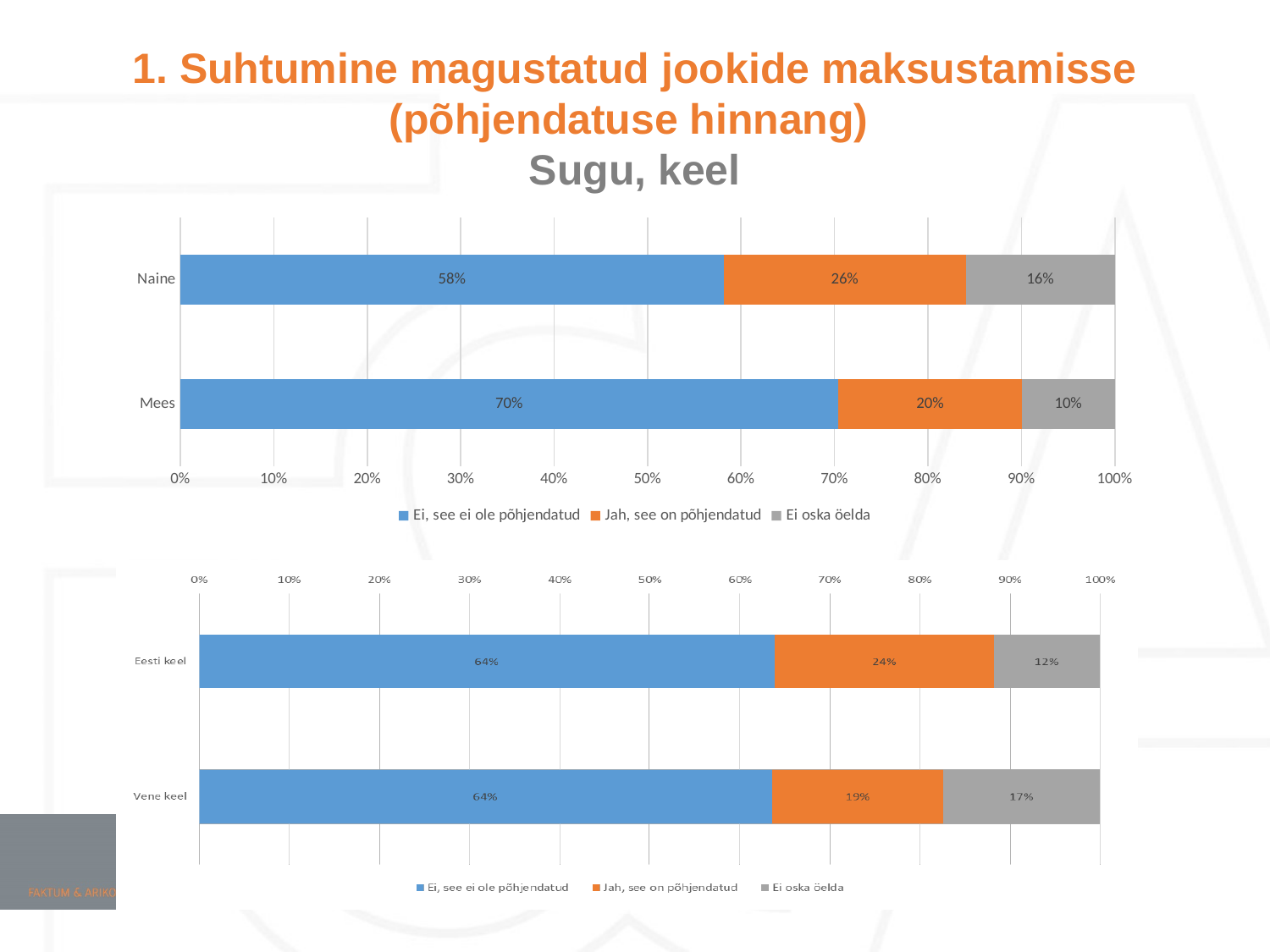
In the top chart (by gender), what is the difference between the 'Ei, see ei ole põhjendatud' values for Mees and Naine? 12% How many categories are shown in the bottom chart (by language)? 2 In the bottom chart (by language), what is the value of 'Jah, see on põhjendatud' for Vene keel? 19% What kind of chart is the bottom chart (by language)? Stacked bar chart In the top chart (by gender), what is the value of 'Ei oska öelda' for Naine? 16% How many series does the legend of the top chart list? 3 In the bottom chart (by language), what is the difference between the 'Jah, see on põhjendatud' values for Eesti keel and Vene keel? 5% In the bottom chart (by language), which is larger: 'Ei oska öelda' for Vene keel or for Eesti keel? Vene keel In the bottom chart (by language), what is the value of 'Ei oska öelda' for Eesti keel? 12% In the top chart (by gender), what is the value of 'Jah, see on põhjendatud' for Mees? 20% In the top chart (by gender), which category has the higher value for 'Ei, see ei ole põhjendatud'? Mees In the top chart (by gender), what is the value of 'Ei, see ei ole põhjendatud' for Naine? 58%